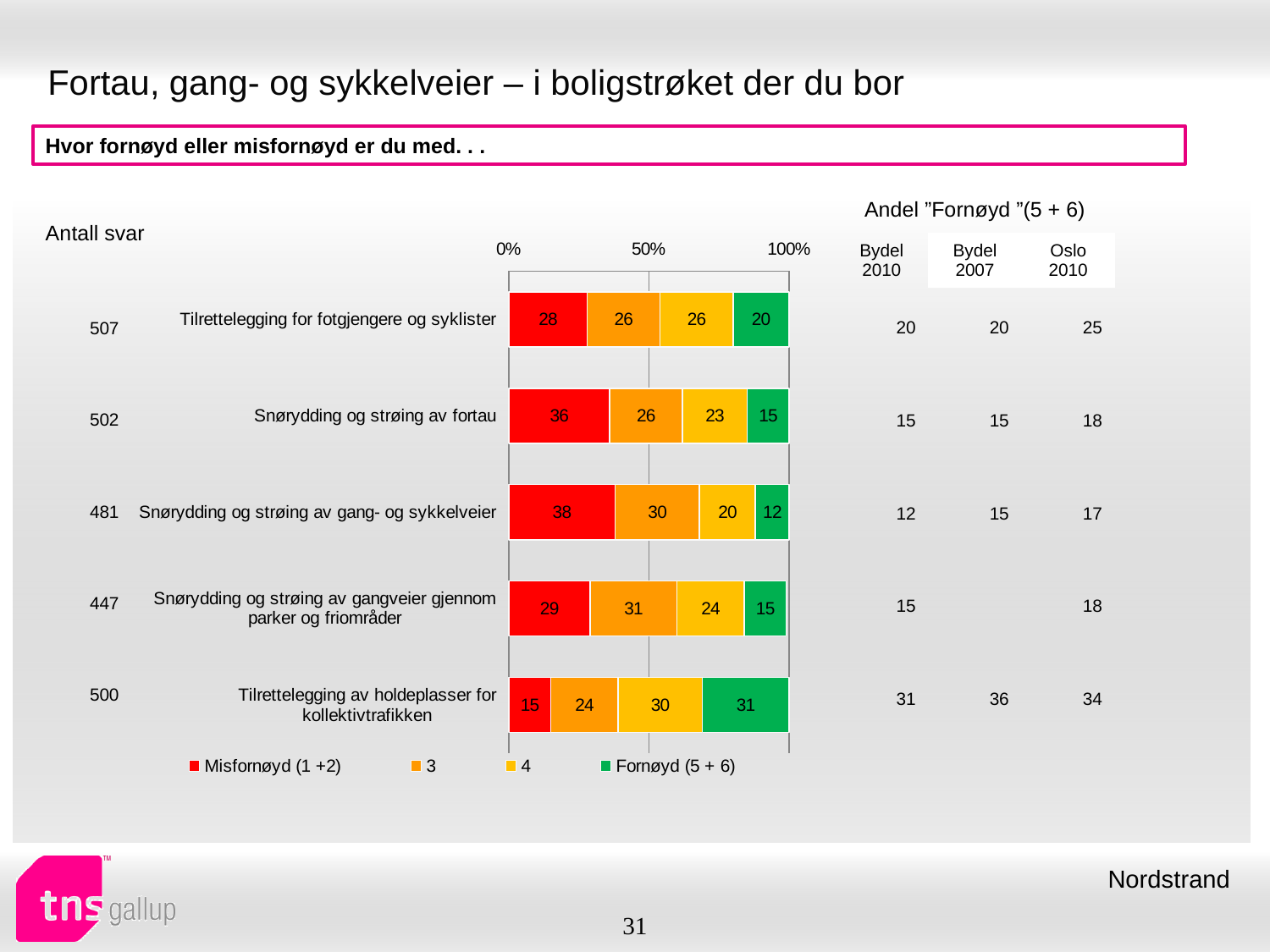
Which category has the highest Misfornøyd (1 +2) value? Snørydding og strøing av gang- og sykkelveier Which is larger: the Fornøyd (5 + 6) value for Tilrettelegging for fotgjengere og syklister or for Snørydding og strøing av fortau? Tilrettelegging for fotgjengere og syklister How many categories are plotted in the chart? 5 What is the Fornøyd (5 + 6) value for Tilrettelegging av holdeplasser for kollektivtrafikken? 31 What is the Misfornøyd (1 +2) value for Snørydding og strøing av fortau? 36 What is the difference between the Misfornøyd (1 +2) values for Snørydding og strøing av gang- og sykkelveier and Tilrettelegging av holdeplasser for kollektivtrafikken? 23 How many series does the legend list? 4 What kind of chart is shown on the slide? Stacked bar chart What is the value of series 4 for Snørydding og strøing av gangveier gjennom parker og friområder? 24 Which category has the lowest Fornøyd (5 + 6) value? Snørydding og strøing av gang- og sykkelveier What is the total of the stacked bar for Snørydding og strøing av gangveier gjennom parker og friområder? 99 Which colour represents Fornøyd (5 + 6) in the legend? Green